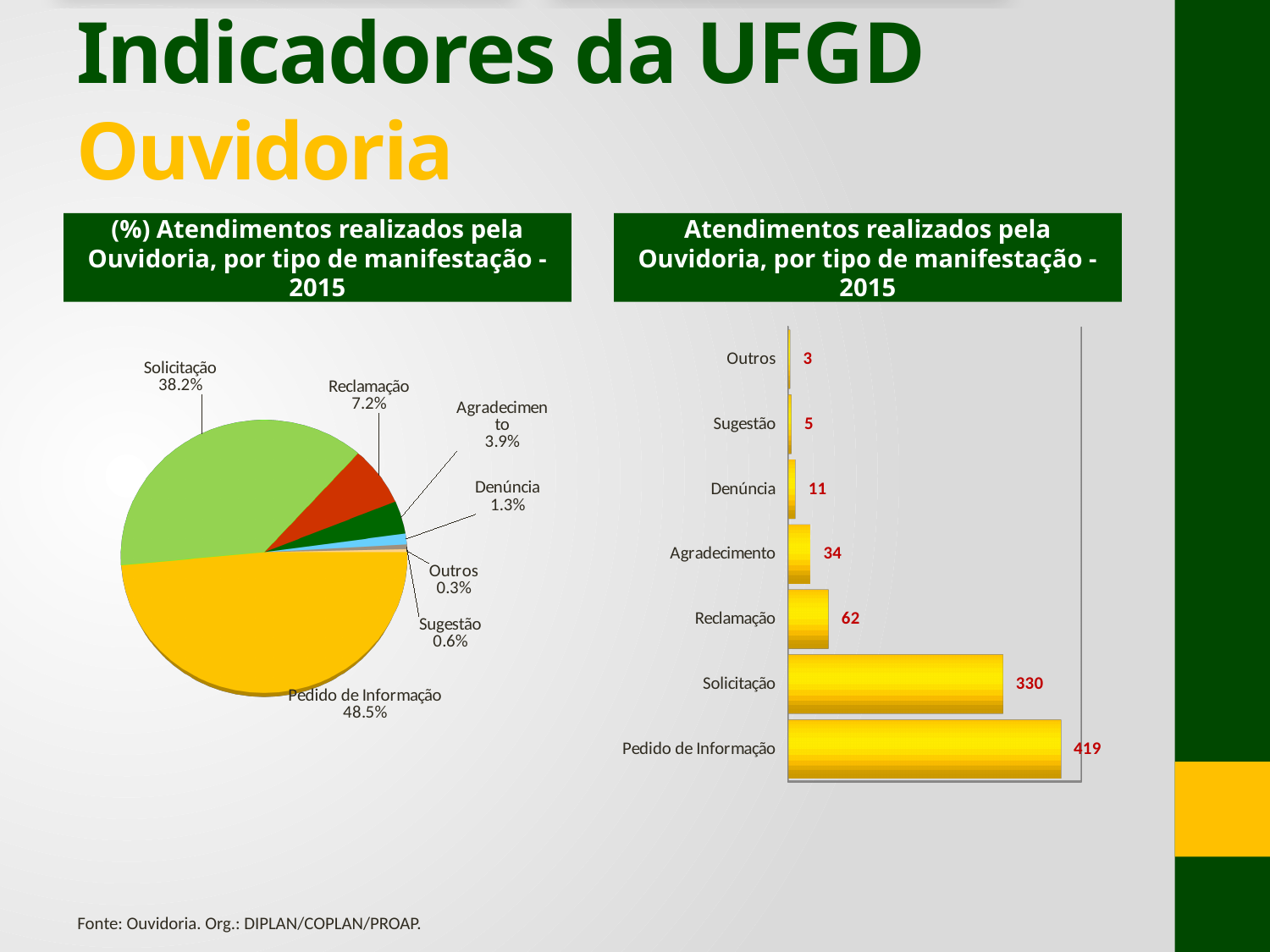
In the pie chart on the left, what share does Denúncia have? 1.3% In the bar chart on the right, what is the difference between Pedido de Informação and Solicitação? 89 In the bar chart on the right, which is larger, Reclamação or Agradecimento? Reclamação How many categories does the bar chart on the right show? 7 In the bar chart on the right, what is the value for Agradecimento? 34 In the bar chart on the right, what is the value for Solicitação? 330 In the pie chart on the left, what share does Pedido de Informação have? 48.5% What kind of chart is the chart on the left? Pie chart In the bar chart on the right, which category has the highest value? Pedido de Informação What kind of chart is the chart on the right? Bar chart In the pie chart on the left, which slice is the smallest? Outros In the bar chart on the right, which category has the lowest value? Outros